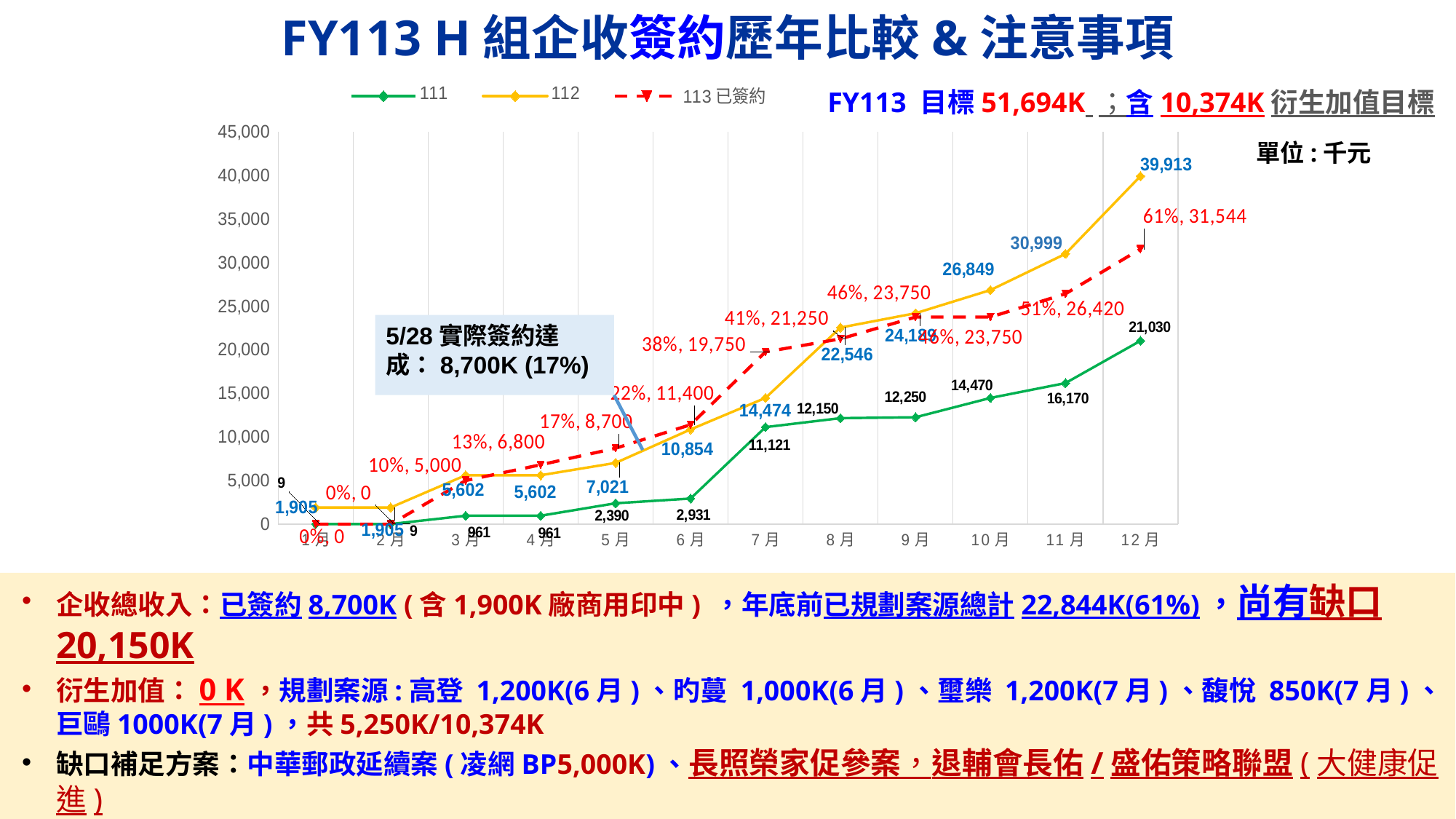
What is the value of series 111 in 7月? 11,121 What kind of chart is shown on the slide? line chart What is the difference between series 112 and series 111 in 12月? 18,883 What unit is stated for the chart values? 千元 In which month does series 112 reach its highest value? 12月 What is the value of series 112 in 12月? 39,913 Does series 112 generally rise or fall from 1月 to 12月? rise How many months are plotted along the x axis? 12 Which series has the larger value in 11月, 111 or 112? 112 What is the value of series 111 in 12月? 21,030 What is the value of series 112 in 6月? 10,854 How many series does the chart legend list? 3